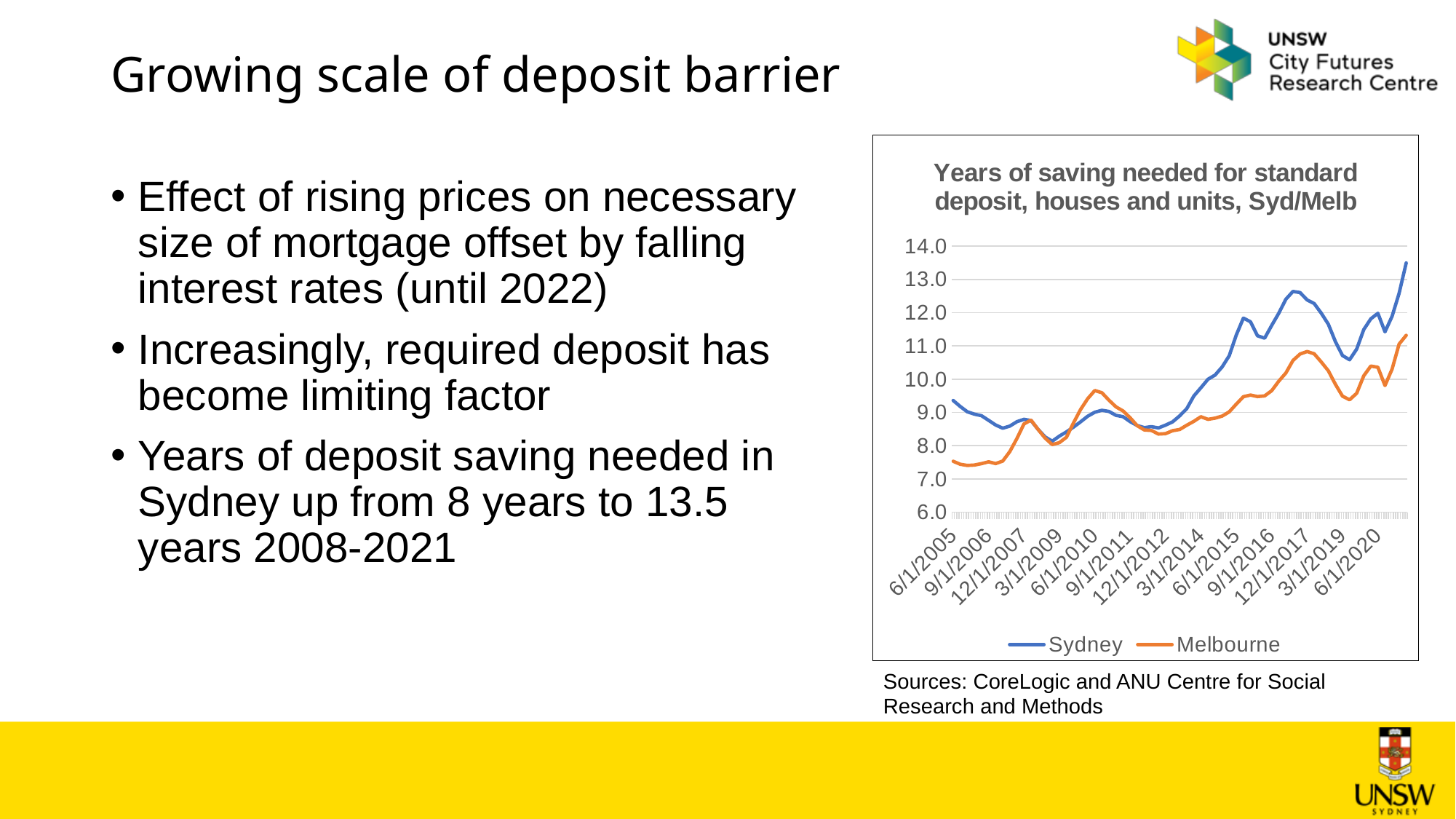
Does the Sydney line overall rise or fall from 6/1/2005 to the end of the series? rise How many date labels are shown on the x axis? 13 Is the final value of the Sydney line greater or less than 13.0? greater What kind of chart is shown on the slide? line chart Is the value for Melbourne at 6/1/2005 greater or less than 8.0? less How many series does the chart legend list? 2 Is the value for Sydney at 6/1/2005 greater or less than 10.0? less Which colour is used for the Melbourne line in the chart? orange What is the title of the chart? Years of saving needed for standard deposit, houses and units, Syd/Melb At 6/1/2005, which series has the higher value, Sydney or Melbourne? Sydney